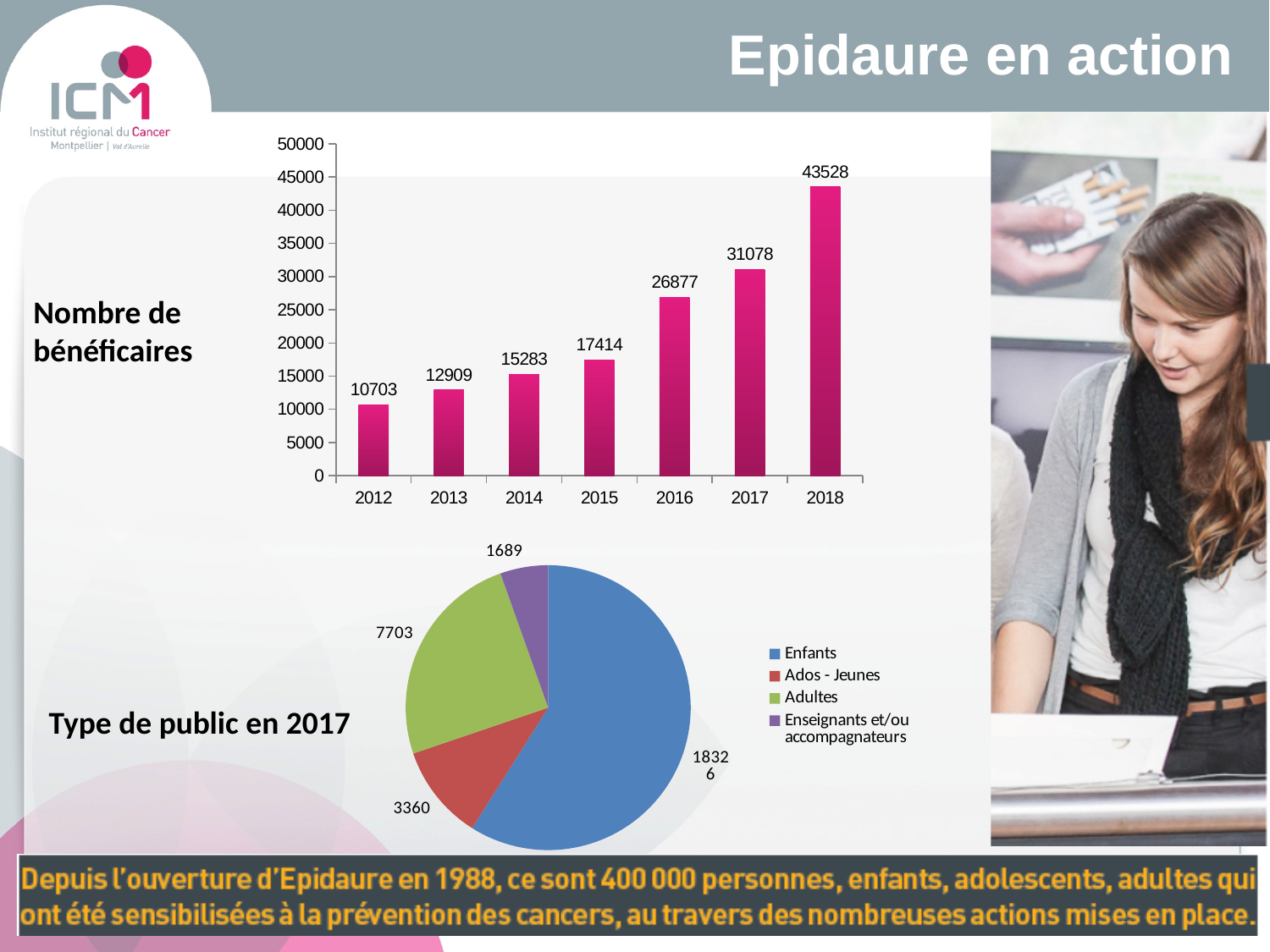
In the pie chart 'Type de public en 2017', which is larger: Ados - Jeunes or Adultes? Adultes What kind of chart is 'Nombre de bénéficaires'? bar chart In the bar chart 'Nombre de bénéficaires', which year has the highest value? 2018 How many years are shown in the bar chart 'Nombre de bénéficaires'? 7 In the pie chart 'Type de public en 2017', what is the value for Adultes? 7703 In the bar chart 'Nombre de bénéficaires', do the values rise or fall from 2012 to 2018? rise In the bar chart 'Nombre de bénéficaires', what is the value for 2018? 43528 In the pie chart 'Type de public en 2017', which category has the smallest slice? Enseignants et/ou accompagnateurs In the bar chart 'Nombre de bénéficaires', which year has the lowest value? 2012 How many categories does the legend of the pie chart 'Type de public en 2017' list? 4 In the bar chart 'Nombre de bénéficaires', what is the value for 2014? 15283 In the bar chart 'Nombre de bénéficaires', what is the difference between the values for 2018 and 2017? 12450